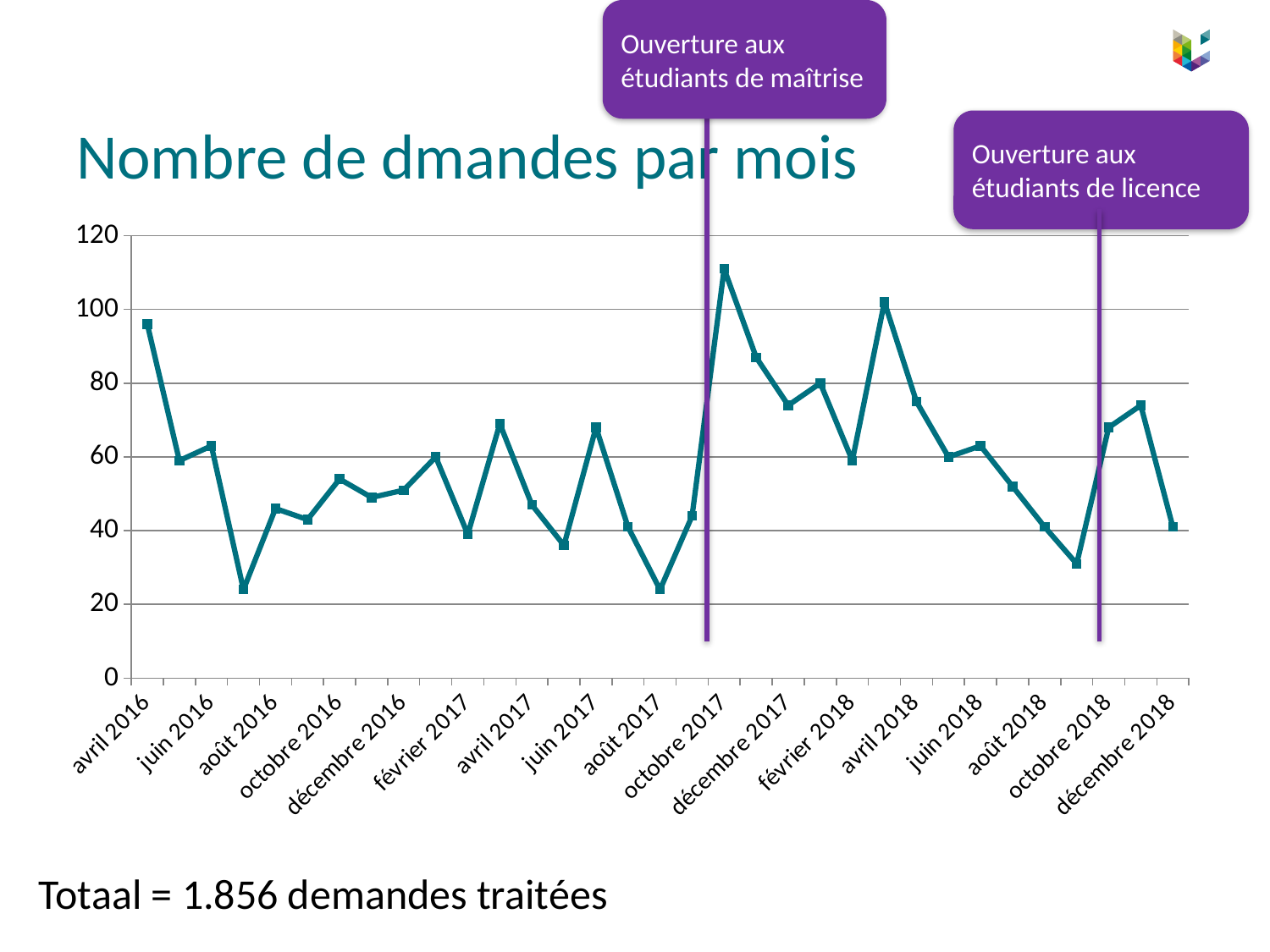
Is the value for octobre 2017 greater or less than 100? greater Is the value for août 2016 greater or less than 60? less Is the value for juin 2017 greater or less than 40? greater What kind of chart is shown on the slide? line chart Which month has the highest number of requests in the chart? octobre 2017 Which is larger, the value for avril 2016 or the value for juin 2016? avril 2016 How many month labels are shown on the x axis? 17 What is the title of the chart? Nombre de dmandes par mois Which is larger, the value for décembre 2017 or the value for décembre 2018? décembre 2017